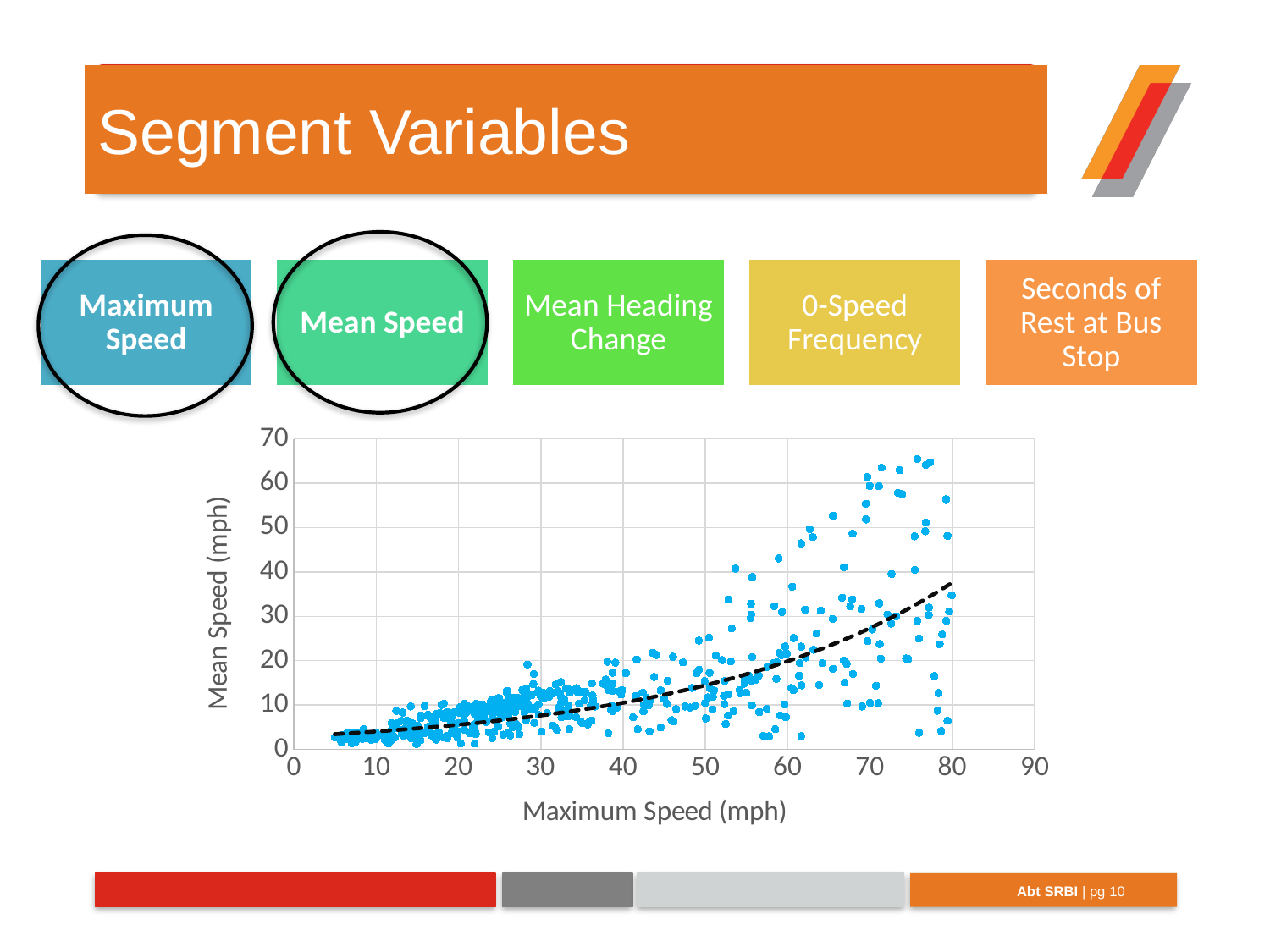
What is the highest value shown on the y axis of the chart? 70 Does mean speed generally increase or decrease as maximum speed increases in the scatter chart? increase What is the label of the x axis of the chart? Maximum Speed (mph) Is the value of the dashed trend line at a maximum speed of 60 mph greater or less than 30? less What is the label of the y axis of the chart? Mean Speed (mph) Is the value of the dashed trend line at a maximum speed of 20 mph greater or less than 10? less What kind of chart is shown on the slide? scatter chart As maximum speed increases along the x axis, does the dashed trend line rise or fall? rise Is the value of the dashed trend line at a maximum speed of 80 mph greater or less than 30? greater